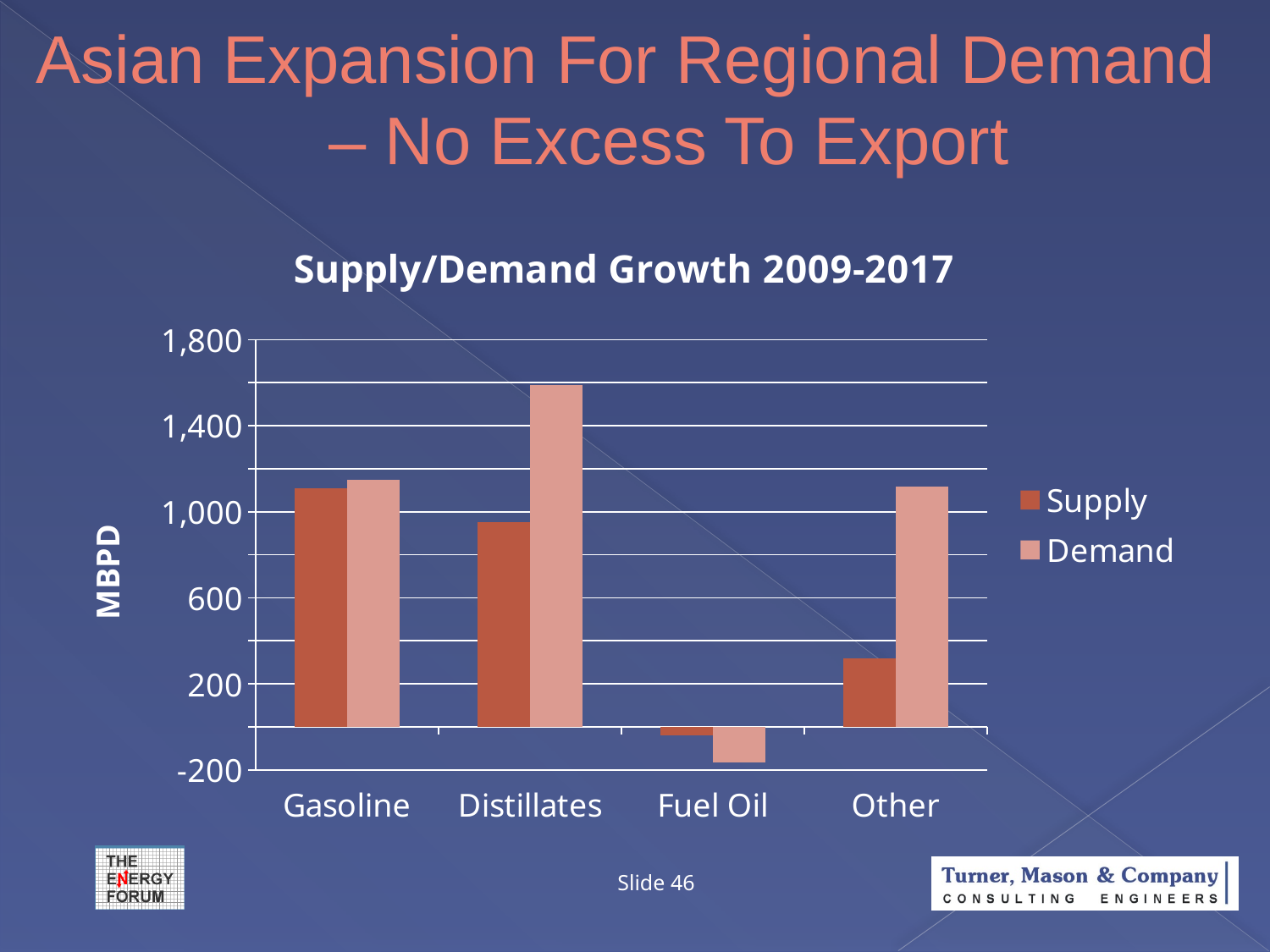
Is the Demand value for Distillates greater or less than 1,400? greater For Distillates, which is larger, Supply or Demand? Demand Which category has the lowest Demand value? Fuel Oil Is the Supply value for Other greater or less than 600? less What unit is shown on the y axis label? MBPD What kind of chart is shown on the slide? bar chart How many categories are shown on the x axis? 4 How many series does the legend list? 2 For Other, which is larger, Supply or Demand? Demand What is the title of the chart? Supply/Demand Growth 2009-2017 Which category has the highest Demand value? Distillates Which category has the highest Supply value? Gasoline